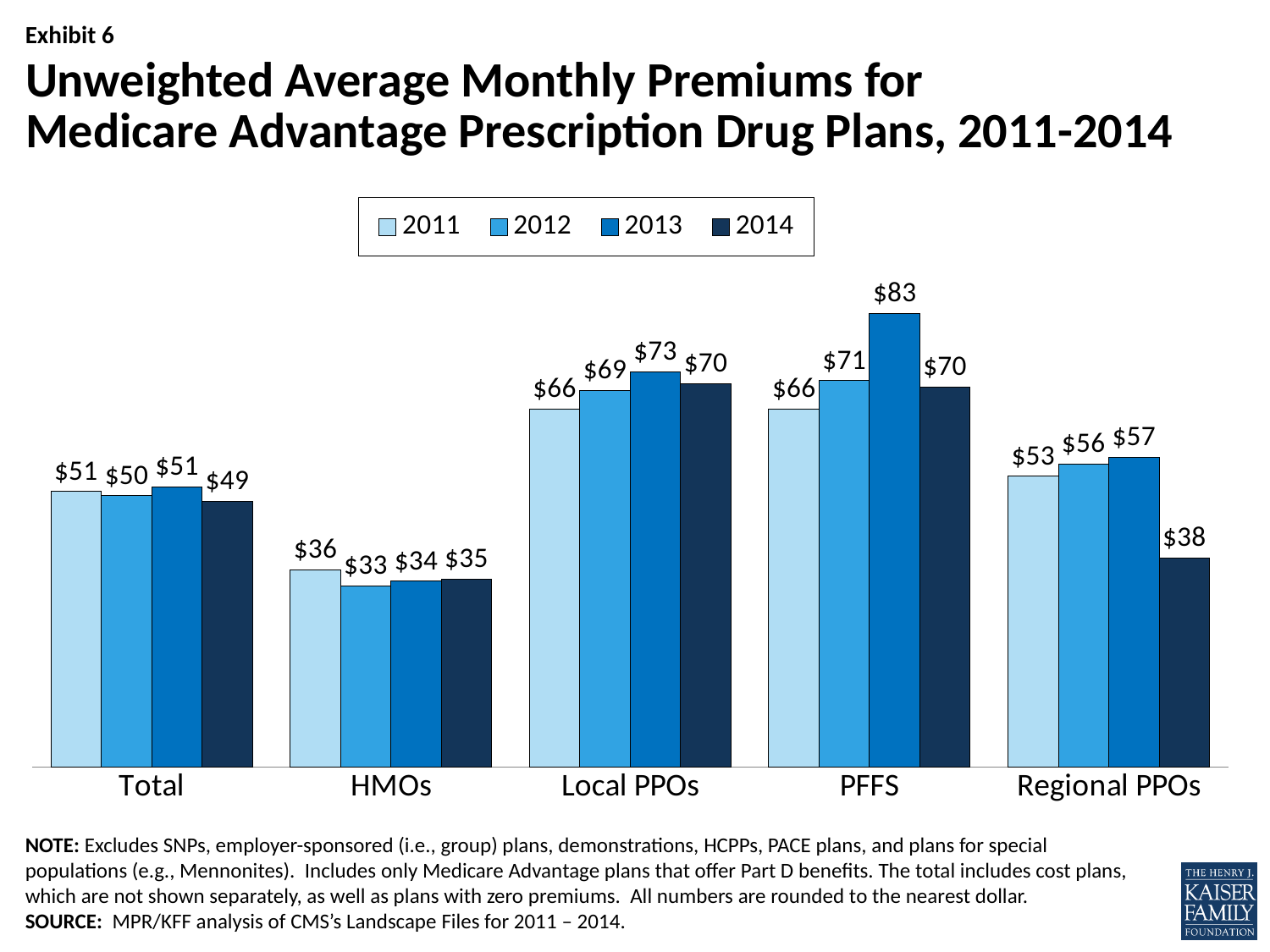
Which category has the lowest 2014 value? HMOs Which is larger, the 2014 value for Local PPOs or the 2014 value for Regional PPOs? Local PPOs Which category has the highest 2013 value? PFFS What is the difference between the 2013 and 2014 values for PFFS? $13 What is the 2011 value for HMOs? $36 What is the 2014 value for Regional PPOs? $38 How many categories are shown on the x axis? 5 Do the values for Local PPOs rise or fall from 2011 to 2013? rise What is the 2013 value for PFFS? $83 What is the 2012 value for Local PPOs? $69 What kind of chart is shown? bar chart How many series does the legend list? 4